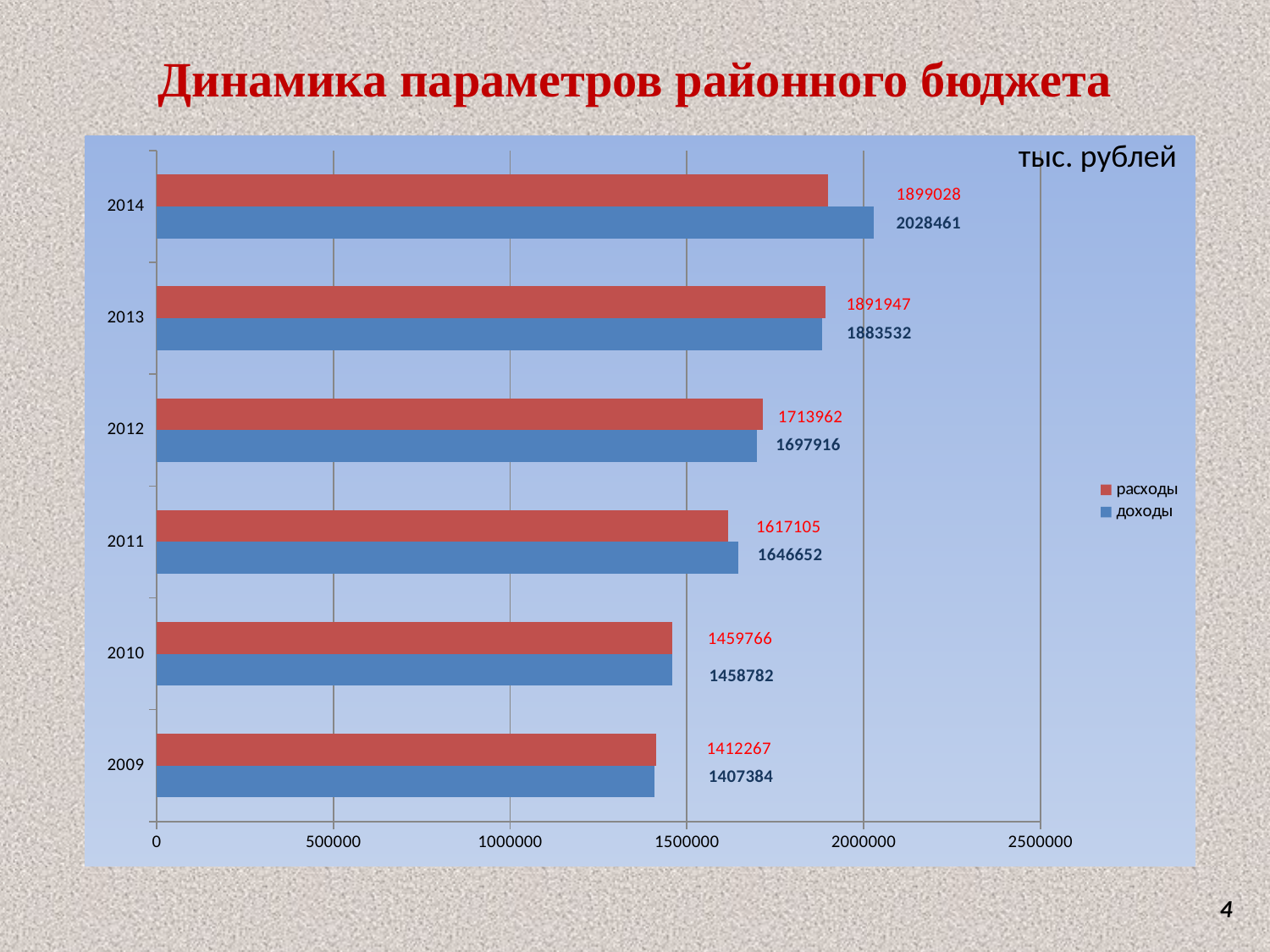
Do the values of доходы rise or fall from 2009 to 2014? rise How many series does the legend list? 2 What is the difference between доходы and расходы in 2011? 29547 How many years are shown on the chart? 6 What is the value of расходы for 2014? 1899028 What is the value of доходы for 2009? 1407384 Which year has the lowest value of расходы? 2009 What is the difference between доходы and расходы in 2014? 129433 In 2013, which is larger: расходы or доходы? расходы What is the value of доходы for 2011? 1646652 What kind of chart is shown on the slide? bar chart Which year has the highest value of доходы? 2014